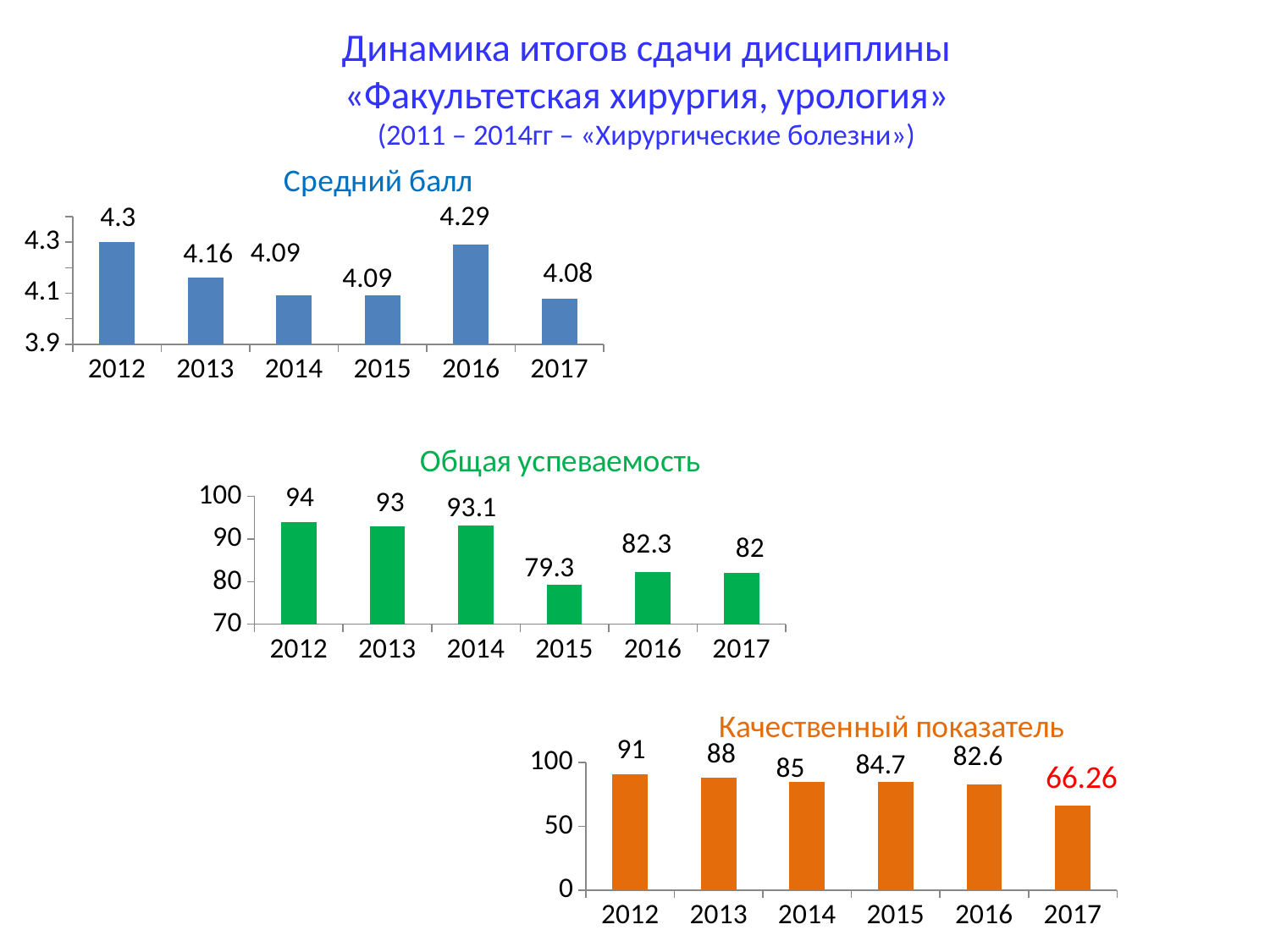
In the "Средний балл" chart, which year has the highest value? 2012 In the "Средний балл" chart, how many years are shown on the x axis? 6 In the "Средний балл" chart, what is the value for 2016? 4.29 What kind of chart is the "Качественный показатель" chart? bar chart In the "Общая успеваемость" chart, what is the value for 2015? 79.3 In the "Общая успеваемость" chart, which year has the lowest value? 2015 In the "Качественный показатель" chart, what colour is the data label for 2017? red In the "Общая успеваемость" chart, which is larger, the value for 2013 or the value for 2016? 2013 In the "Качественный показатель" chart, do the values rise or fall from 2012 to 2017? fall In the "Общая успеваемость" chart, what is the difference between the values for 2012 and 2017? 12 In the "Качественный показатель" chart, what is the value for 2017? 66.26 In the "Качественный показатель" chart, what is the difference between the values for 2012 and 2014? 6